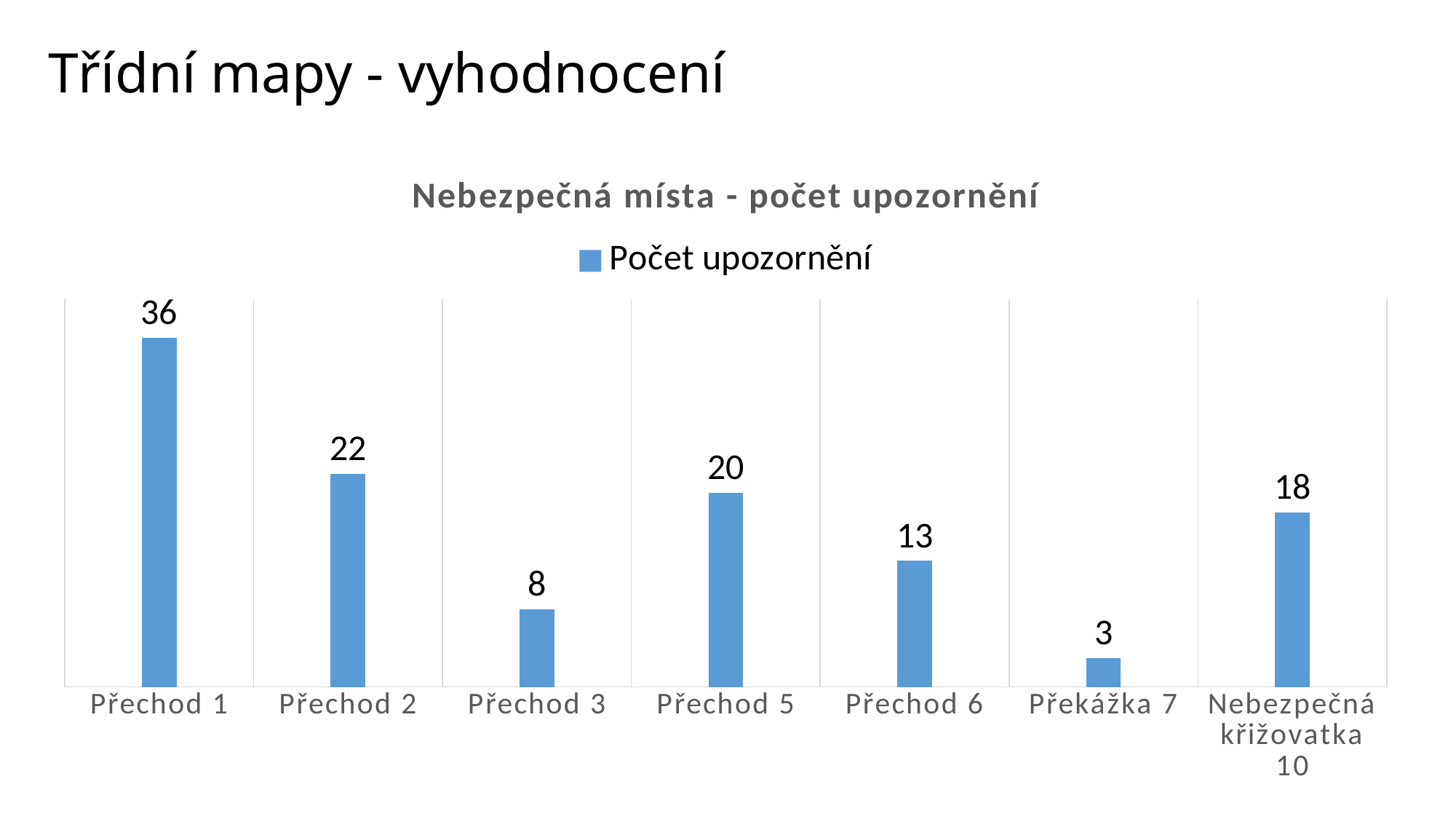
What is the difference between the values for Přechod 6 and Přechod 3? 5 What kind of chart is shown? bar chart What is the value for Přechod 1? 36 Which is larger, the value for Přechod 2 or the value for Přechod 5? Přechod 2 What is the difference between the values for Přechod 1 and Přechod 2? 14 What is the title of the chart? Nebezpečná místa - počet upozornění Which category has the lowest value? Překážka 7 Which category has the highest value? Přechod 1 How many series does the legend list? 1 How many categories are shown on the x axis? 7 What is the value for Přechod 5? 20 What is the value for Nebezpečná křižovatka 10? 18